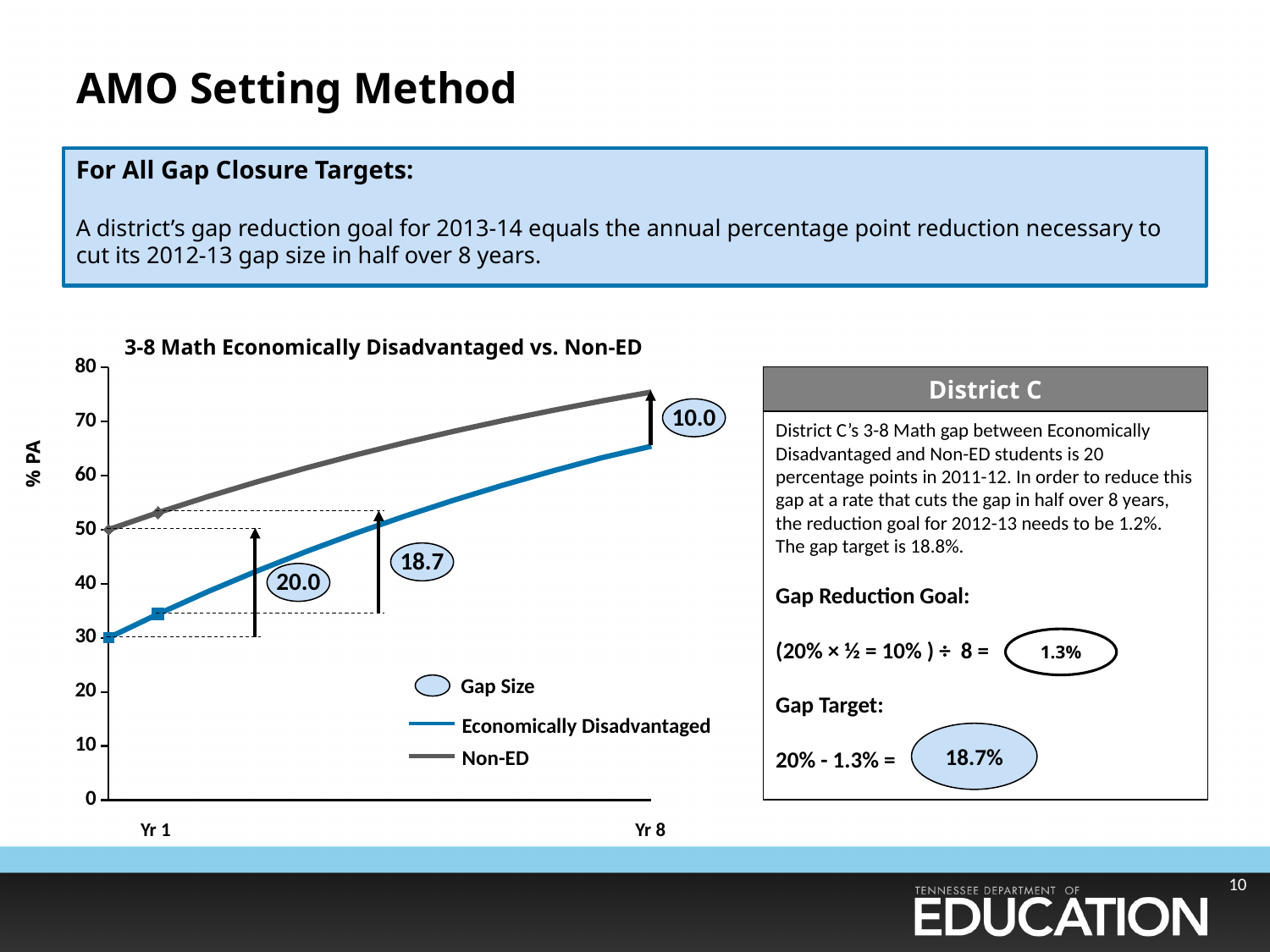
What gap size is labelled at Yr 1 on the chart? 20.0 Is the Non-ED value at Yr 8 greater or less than 70? greater What type of chart is shown on the slide? line chart How many entries does the chart legend list? 3 What is the title of the chart? 3-8 Math Economically Disadvantaged vs. Non-ED What is the label on the y axis of the chart? % PA What is the difference between the gap size at Yr 1 and the gap size at Yr 8? 10.0 What gap size is labelled at Yr 8 on the chart? 10.0 What is the gap size labelled between the Yr 1 and Yr 8 gap labels on the chart? 18.7 Is the Economically Disadvantaged value at Yr 1 greater or less than 40? less Do the Economically Disadvantaged values rise or fall from Yr 1 to Yr 8? rise Which of the labelled gap sizes on the chart is the smallest? 10.0